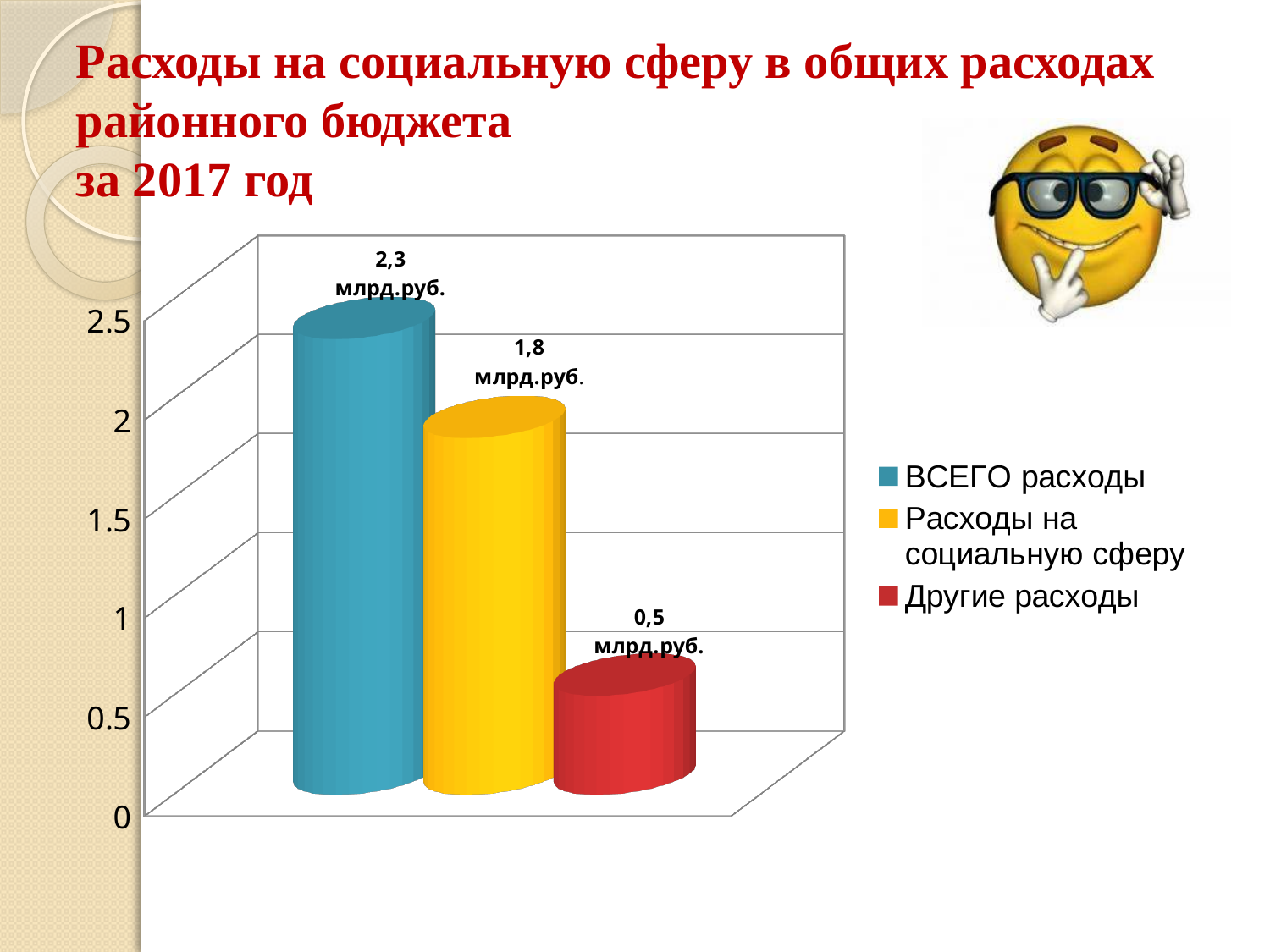
Is the value for ВСЕГО расходы greater or less than 2? greater Which series has the highest value? ВСЕГО расходы What is the difference between ВСЕГО расходы and Расходы на социальную сферу? 0,5 млрд.руб. What value is shown for Расходы на социальную сферу? 1,8 млрд.руб. What is the difference between Расходы на социальную сферу and Другие расходы? 1,3 млрд.руб. What kind of chart is shown on the slide? bar chart Which is larger, Расходы на социальную сферу or Другие расходы? Расходы на социальную сферу What value is shown for Другие расходы? 0,5 млрд.руб. What value is shown for ВСЕГО расходы? 2,3 млрд.руб. What colour is the bar for Другие расходы? red Which series has the lowest value? Другие расходы How many series does the legend list? 3